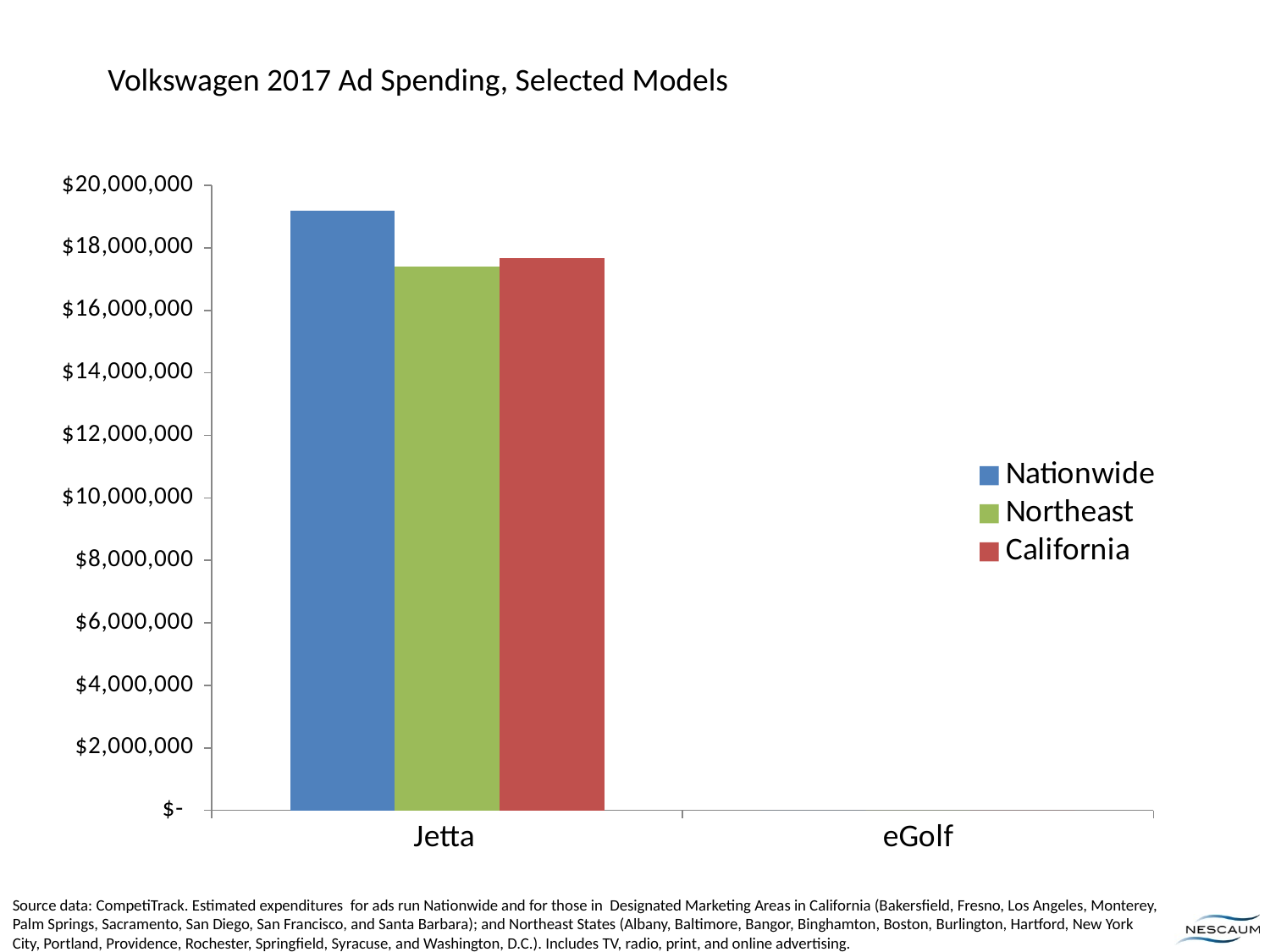
Which series has the highest ad spending for the Jetta? Nationwide For the Jetta, which is larger: Nationwide or Northeast ad spending? Nationwide What kind of chart is shown on the slide? bar chart What is the title of the chart? Volkswagen 2017 Ad Spending, Selected Models Is the Nationwide ad spending for the Jetta greater or less than $20,000,000? less Is the Nationwide ad spending for the Jetta greater or less than $18,000,000? greater How many car models are shown on the x axis? 2 Is the California ad spending for the Jetta greater or less than $16,000,000? greater Which model has the lower ad spending across all series, Jetta or eGolf? eGolf Which colour represents the California series in the legend? red How many series does the legend list? 3